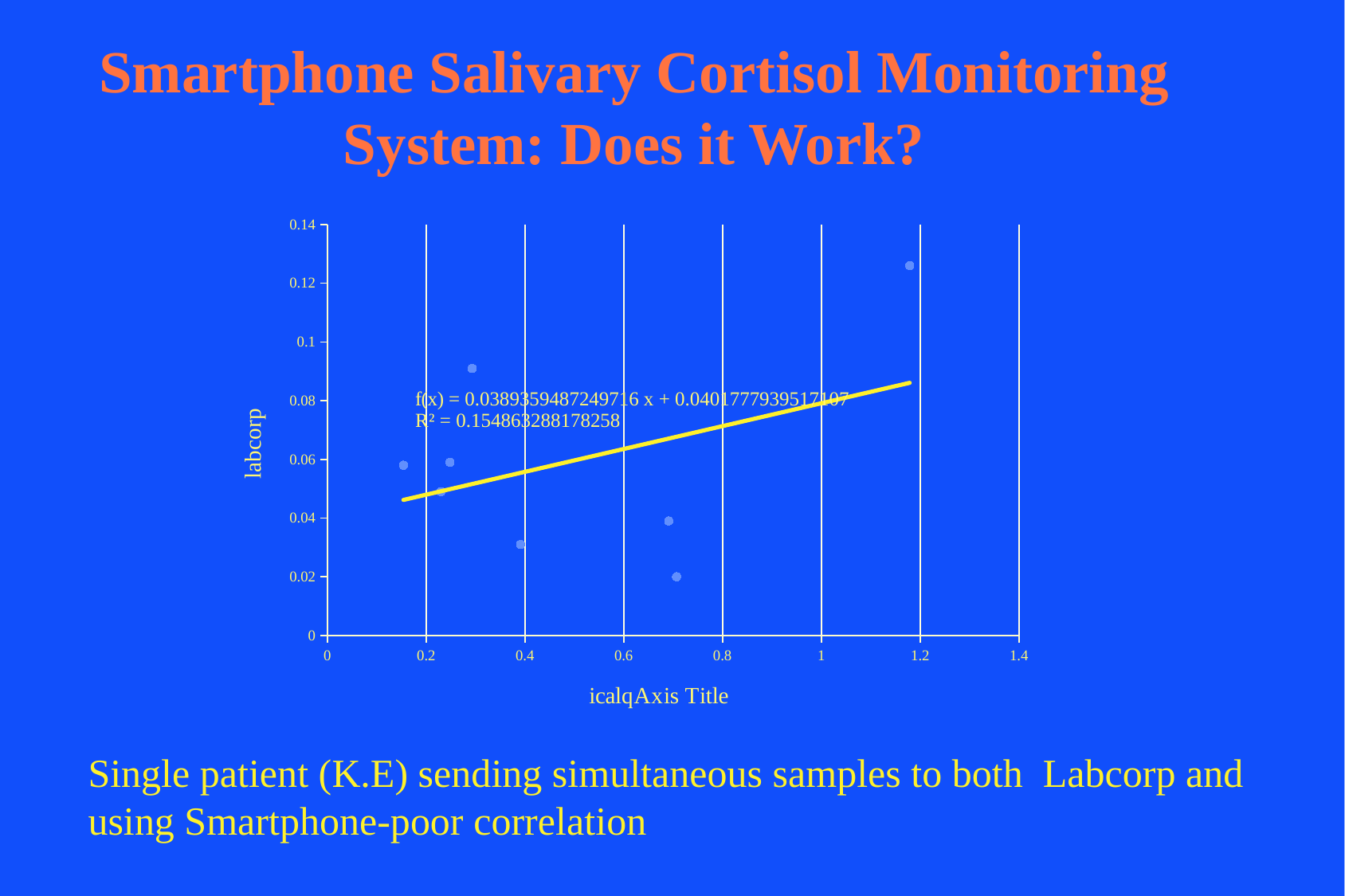
How many data points are plotted on the chart? 8 What R² value is printed on the chart? 0.154863288178258 What kind of chart is shown on the slide? scatter chart Is the lowest labcorp value on the chart greater or less than 0.04? less Is the labcorp value of the point with the largest x value (near 1.2) greater or less than 0.12? greater Does the fitted trendline rise or fall as the x value increases? rises What is the title of the vertical axis? labcorp Is the labcorp value of the point near x = 0.3 greater or less than 0.08? greater Which has the larger labcorp value: the point near x = 0.3 or the point near x = 0.4? the point near x = 0.3